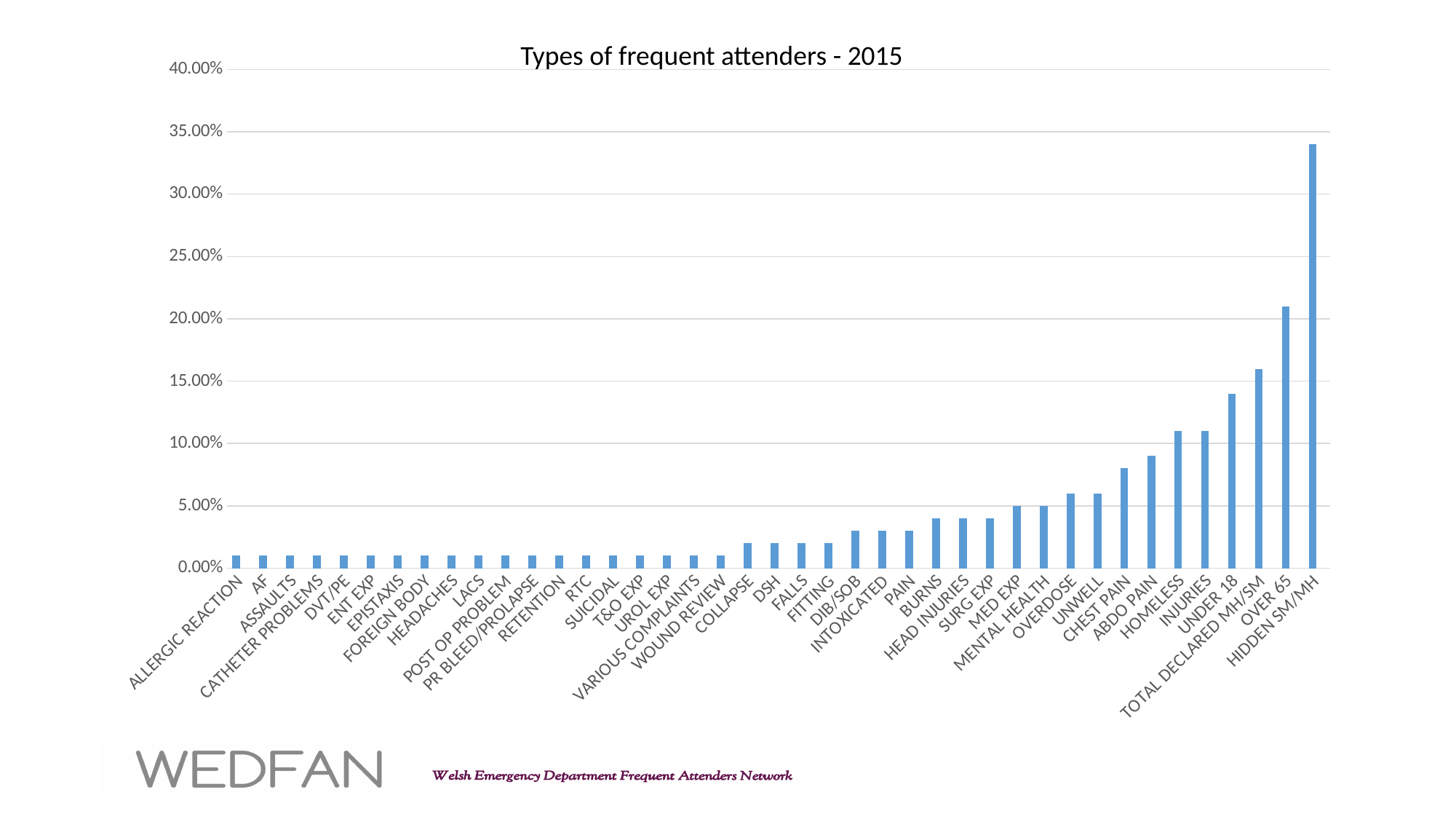
Is the value for HIDDEN SM/MH greater or less than 30.00%? greater Is the value for UNDER 18 greater or less than 15.00%? less Is the value for COLLAPSE greater or less than 5.00%? less Which is larger, the value for HIDDEN SM/MH or the value for OVER 65? HIDDEN SM/MH What is the title of the chart? Types of frequent attenders - 2015 Do the values generally rise or fall moving left to right along the x axis? Rise What kind of chart is shown on the slide? Bar chart Which category has the highest value? HIDDEN SM/MH How many categories are plotted on the x axis? 41 Which is larger, the value for UNDER 18 or the value for HOMELESS? UNDER 18